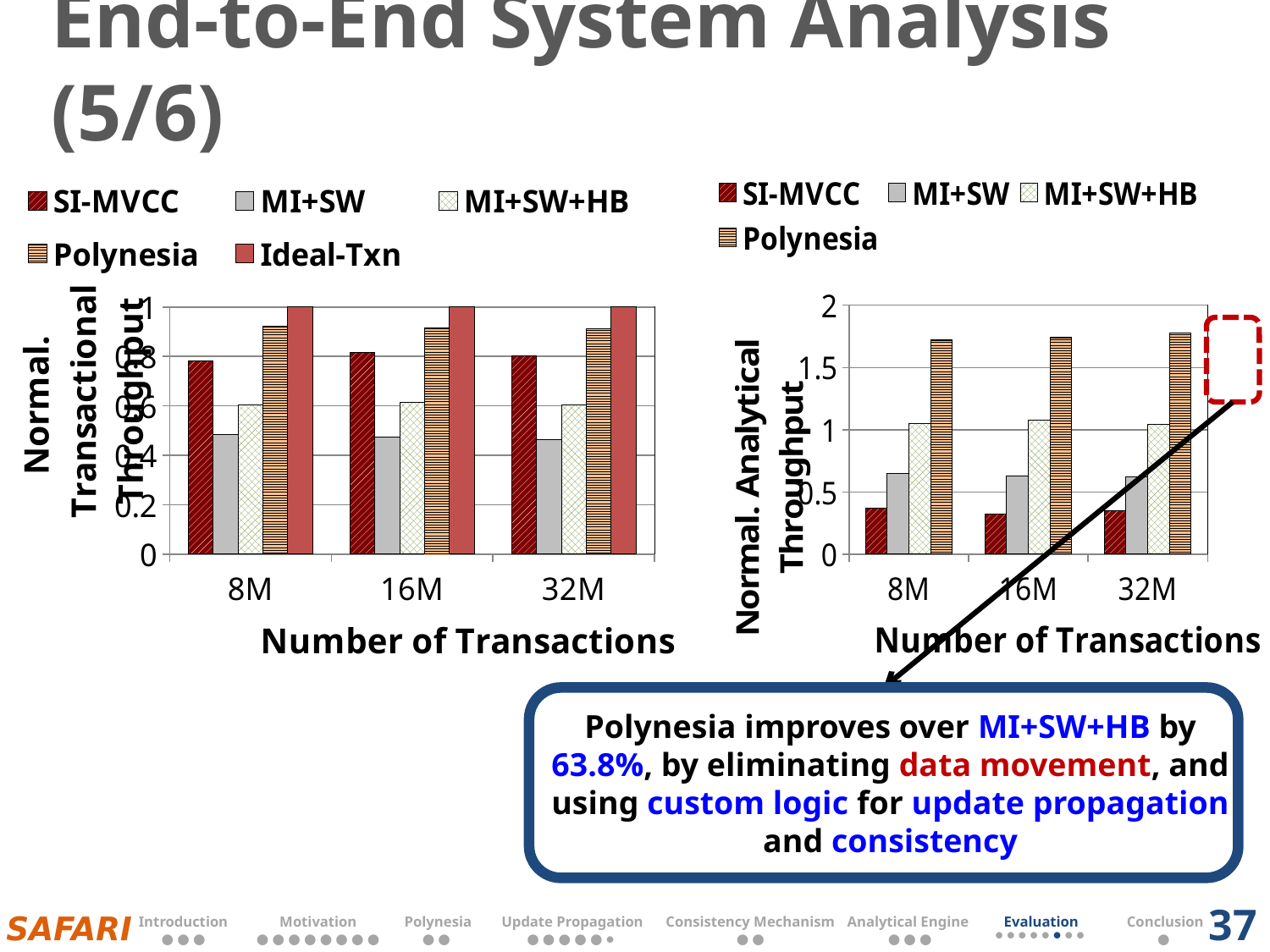
On the right chart (Normal. Analytical Throughput), which series has the highest value at 32M? Polynesia On the right chart (Normal. Analytical Throughput), is the value for SI-MVCC at 8M greater or less than 0.5? less On the right chart (Normal. Analytical Throughput), how many categories are shown on the x axis? 3 On the right chart (Normal. Analytical Throughput), how many series does the legend list? 4 On the right chart (Normal. Analytical Throughput), is the value for Polynesia at 8M greater or less than 1.5? greater On the left chart (Normal. Transactional Throughput), what is the value for Ideal-Txn at 8M? 1 On the right chart (Normal. Analytical Throughput), which series has the lowest value at 16M? SI-MVCC On the left chart (Normal. Transactional Throughput), is the value for MI+SW at 8M greater or less than 0.6? less On the left chart (Normal. Transactional Throughput), how many series does the legend list? 5 On the left chart (Normal. Transactional Throughput), which series has the lowest value at 16M? MI+SW On the left chart (Normal. Transactional Throughput), which is larger at 32M: SI-MVCC or MI+SW? SI-MVCC What kind of chart is the left chart (Normal. Transactional Throughput)? Bar chart